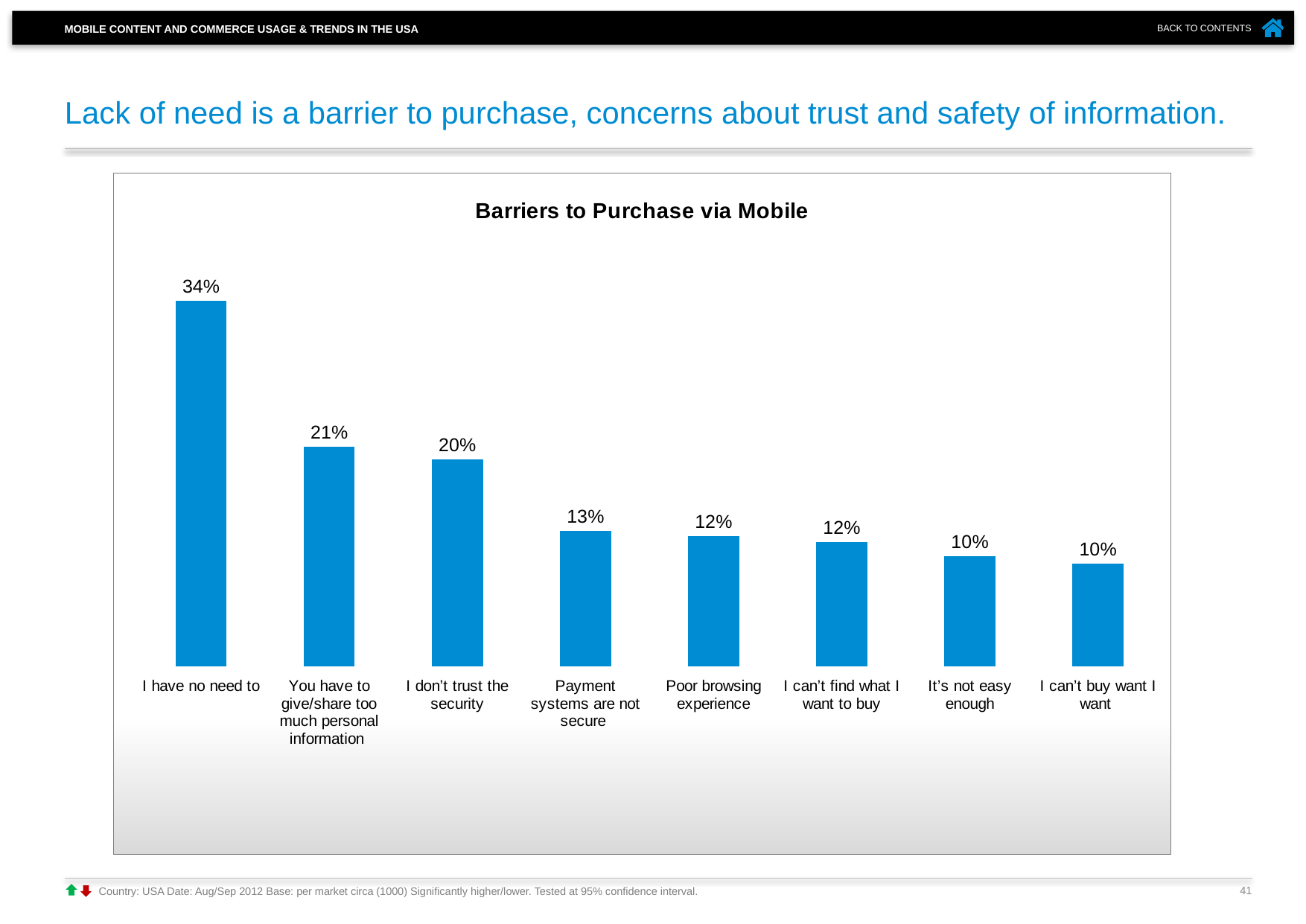
What is the title of the chart? Barriers to Purchase via Mobile What is the value for "Payment systems are not secure"? 13% How many barriers are shown in the chart? 8 What kind of chart is shown? Bar chart Which barrier has the highest value? I have no need to What is the difference between "I don't trust the security" and "Payment systems are not secure"? 7% What is the value for "Poor browsing experience"? 12% What is the difference between "I have no need to" and "You have to give/share too much personal information"? 13% What is the value for "I have no need to"? 34% Do the values rise or fall from left to right across the chart? Fall Which is larger, "You have to give/share too much personal information" or "It's not easy enough"? You have to give/share too much personal information What is the value for "I don't trust the security"? 20%